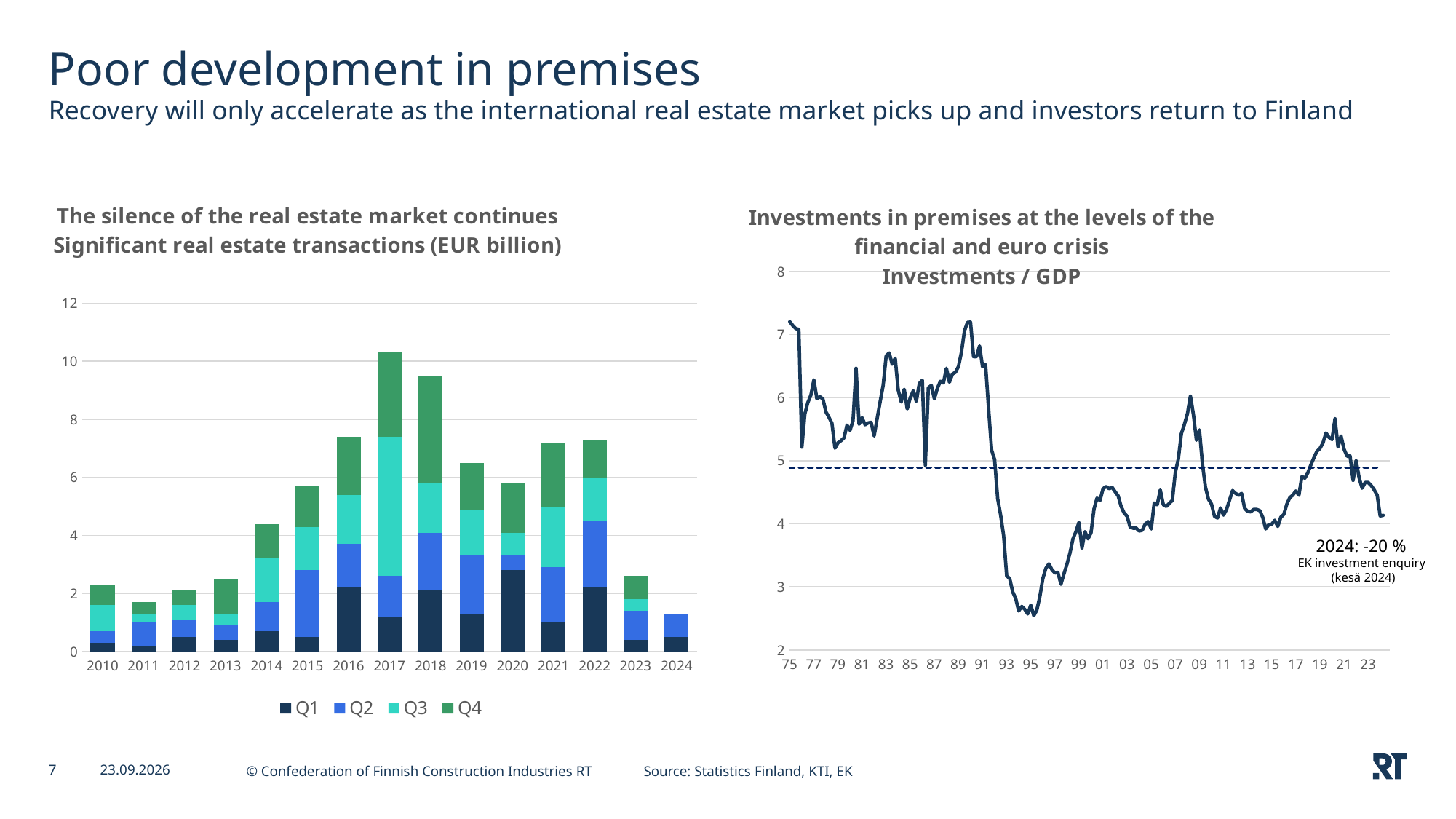
In the left chart, which year has the highest total of significant real estate transactions? 2017 In the right chart, what percentage change for 2024 is annotated next to the line? -20 % What kind of chart is the left chart, 'The silence of the real estate market continues'? Stacked bar chart In the right chart, is the Investments / GDP value around 1995 greater or less than 3? less What kind of chart is the right chart, 'Investments in premises at the levels of the financial and euro crisis'? Line chart In the left chart, which year has the lowest total of significant real estate transactions? 2024 In the left chart, is the total for 2024 greater or less than 2? less In the left chart, how many years are shown on the x axis? 15 In the left chart, is the total for 2017 greater or less than 10? greater In the left chart, do the totals rise or fall from 2022 to 2024? fall In the left chart, which year has the larger total, 2016 or 2020? 2016 In the left chart, how many series does the legend list? 4